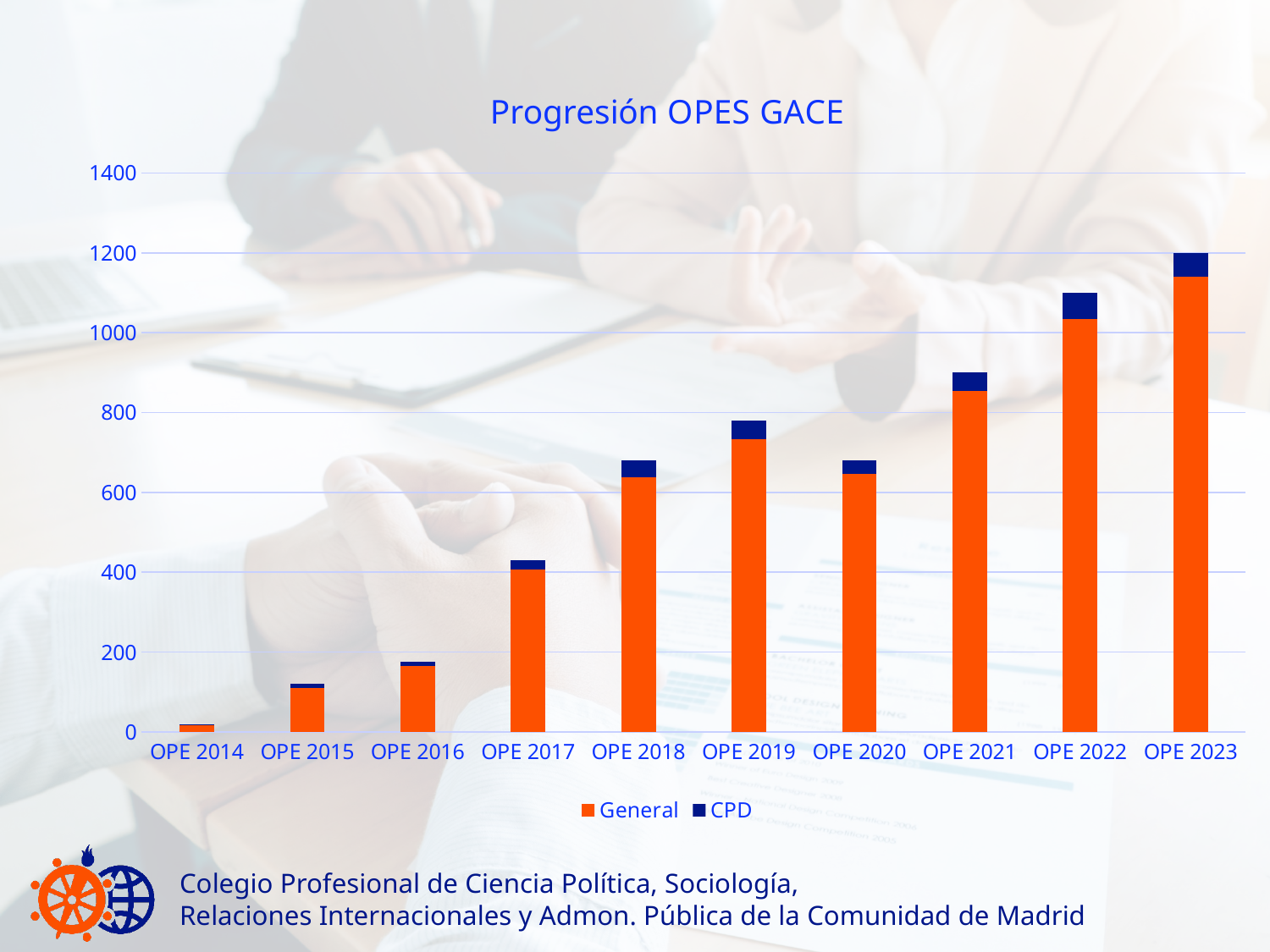
Is the General value for OPE 2019 greater or less than 800? less Is the total stacked value for OPE 2017 greater or less than 400? greater How many series does the legend list? 2 Is the total stacked value for OPE 2016 greater or less than 200? less Which OPE has the tallest stacked bar? OPE 2023 Which has the larger total stacked bar, OPE 2019 or OPE 2020? OPE 2019 What is the title of the chart? Progresión OPES GACE Which colour represents the CPD series in the legend? Dark blue What kind of chart is shown on the slide? Bar chart Which OPE has the shortest stacked bar? OPE 2014 How many OPE categories are shown on the x axis? 10